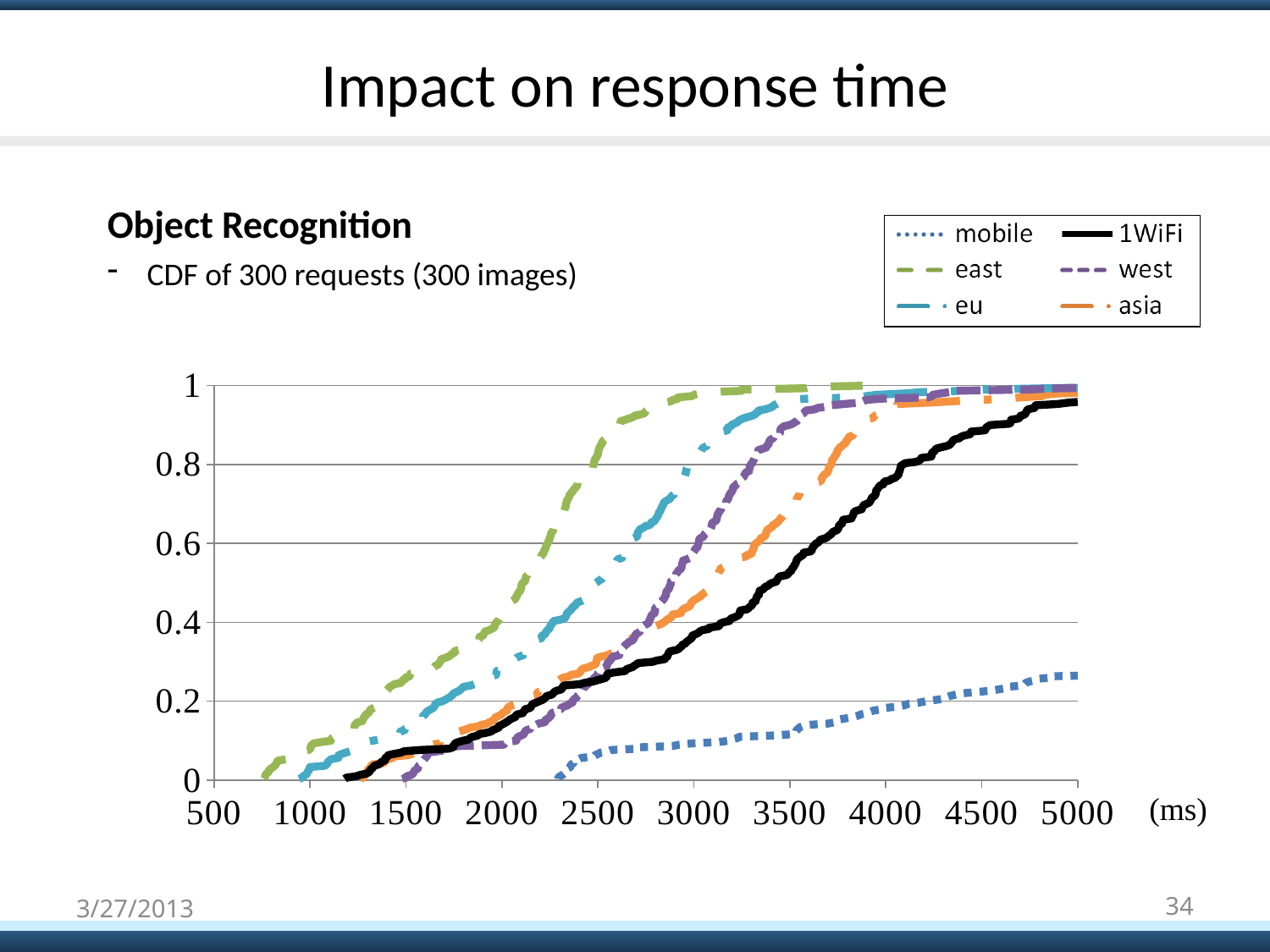
Which series are listed in the legend? mobile, 1WiFi, east, west, eu, asia Is the value for the 1WiFi series at 4000 ms greater or less than 0.6? greater Which series has the highest value at 3000 ms? east Is the value for the east series at 3000 ms greater or less than 0.8? greater Which series has the lowest value at 3000 ms? mobile How many series does the legend list? 6 What unit is shown on the x axis? ms At 4000 ms, which series has the larger value, 1WiFi or mobile? 1WiFi Is the value for the mobile series at 3000 ms greater or less than 0.2? less What kind of chart is shown on the slide? line chart Do the values of the east series rise or fall as the x axis increases? rise